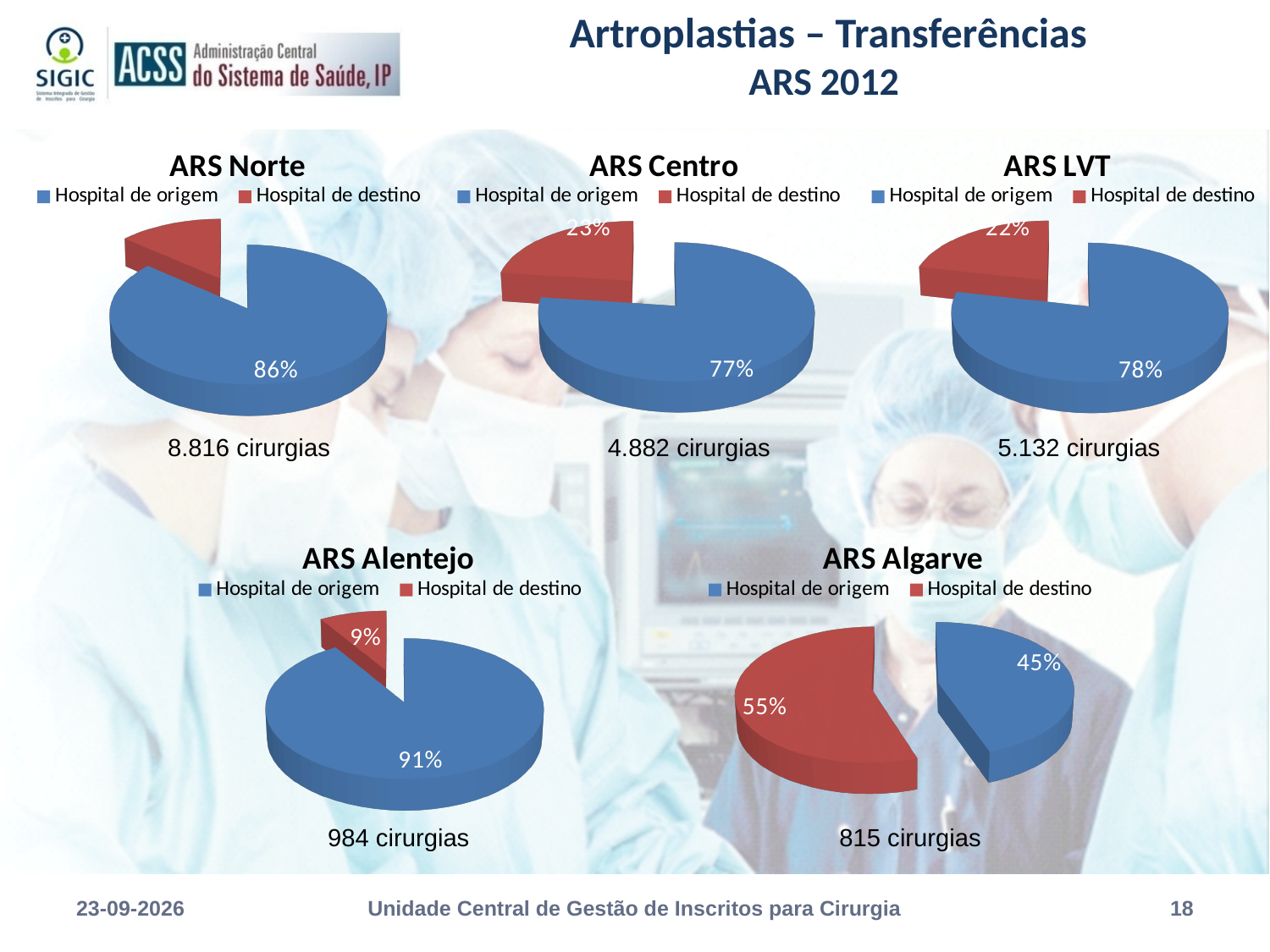
In the ARS LVT pie chart, what share is labelled for Hospital de origem? 78% In the ARS Norte pie chart, what share is labelled for Hospital de origem? 86% In the ARS Centro pie chart, what share is labelled for Hospital de destino? 23% What kind of chart is used for ARS LVT? Pie chart How many series does the legend of the ARS Norte chart list? 2 In the ARS Alentejo pie chart, what share is labelled for Hospital de destino? 9% In the ARS Algarve pie chart, what colour is the Hospital de destino slice? Red In the ARS Centro pie chart, what is the difference between the Hospital de origem and Hospital de destino shares? 54% How many pie charts are shown on the slide? 5 In the ARS Algarve pie chart, what share is labelled for Hospital de destino? 55% In the ARS Algarve pie chart, which slice is larger, Hospital de origem or Hospital de destino? Hospital de destino In the ARS Alentejo pie chart, which slice is the largest? Hospital de origem